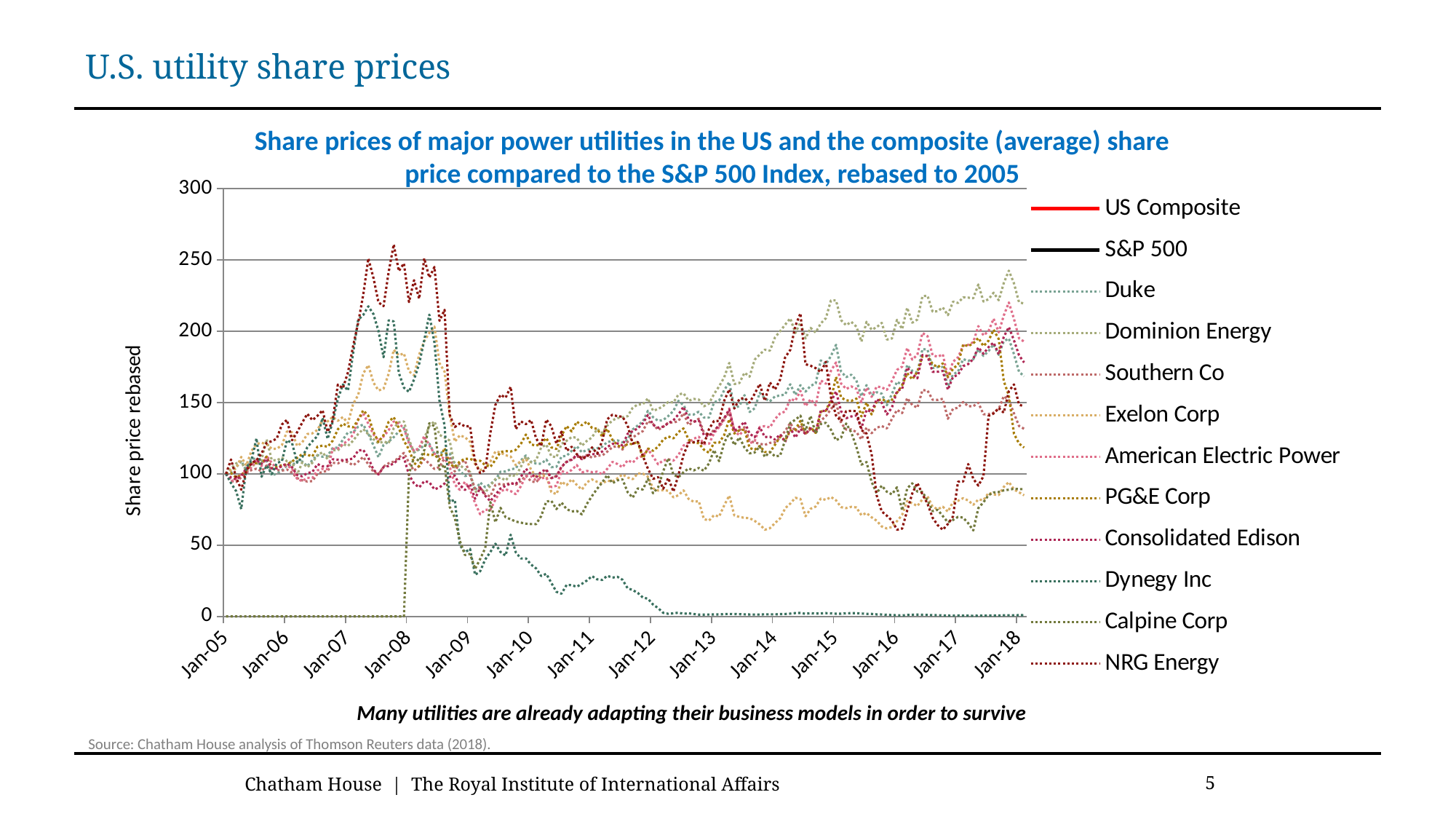
How many series does the legend list? 12 Is the highest peak reached by any series on the chart greater or less than 300? less Is the highest peak reached by any series on the chart greater or less than 250? greater What colour is the US Composite line in the legend? Red What is the title of the chart? Share prices of major power utilities in the US and the composite (average) share price compared to the S&P 500 Index, rebased to 2005 What kind of chart is shown on the slide? Line chart What is the highest value shown on the y axis? 300 How many year labels are shown on the x axis? 14 What is the last year label on the x axis? Jan-18 What is the first year label on the x axis? Jan-05 Which series is listed last in the legend? NRG Energy